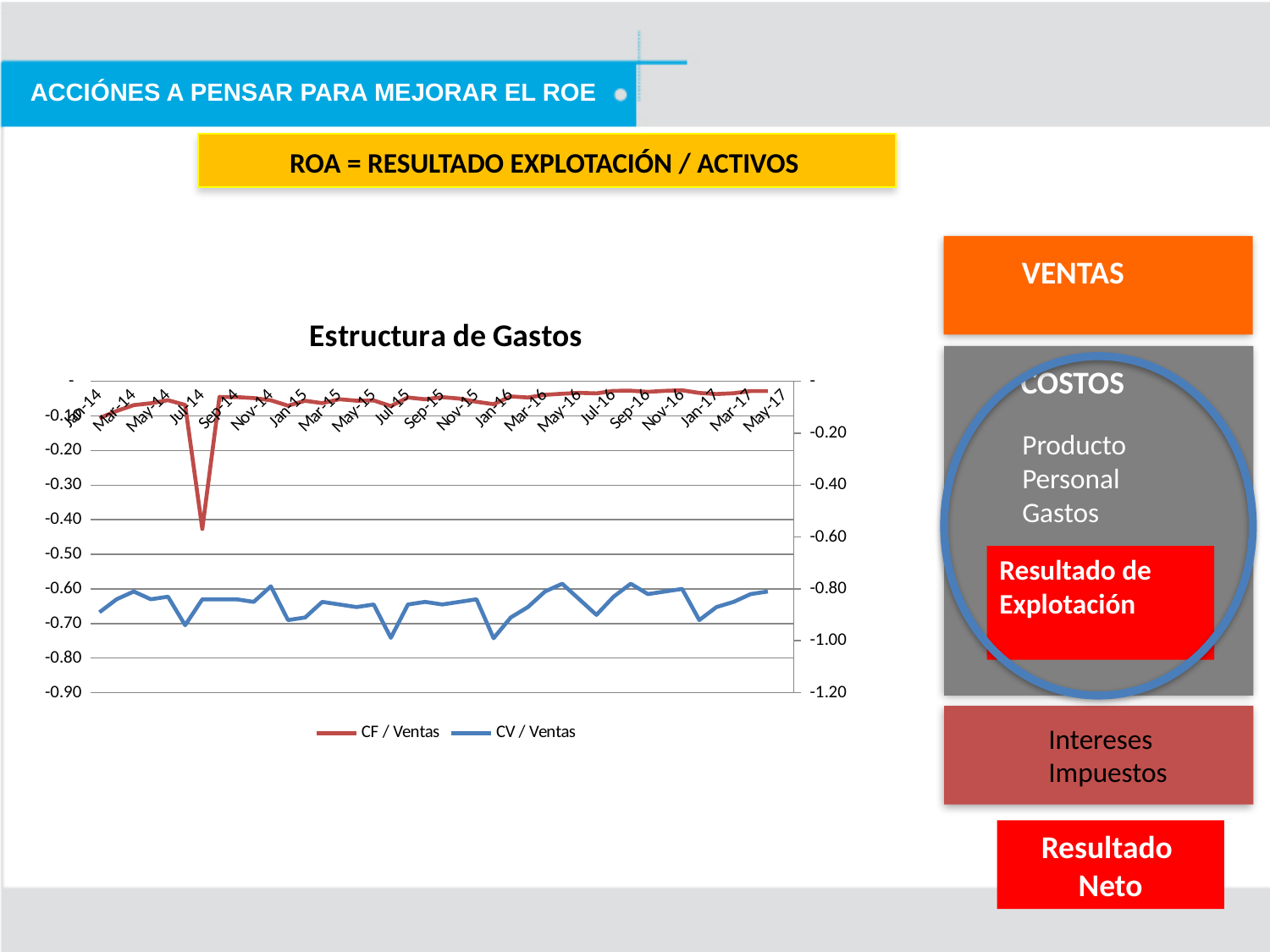
Which series is consistently lower (more negative) across the whole period, CF / Ventas or CV / Ventas? CV / Ventas What is the lowest tick value shown on the left vertical axis? -0.90 What type of chart is shown on the slide? Line chart What is the lowest tick value shown on the right vertical axis? -1.20 How many series does the chart's legend list? 2 Which series is drawn in red in the Estructura de Gastos chart? CF / Ventas What is the last month label on the x axis of the chart? May-17 What is the title of the chart? Estructura de Gastos What is the first month label on the x axis of the chart? Jan-14